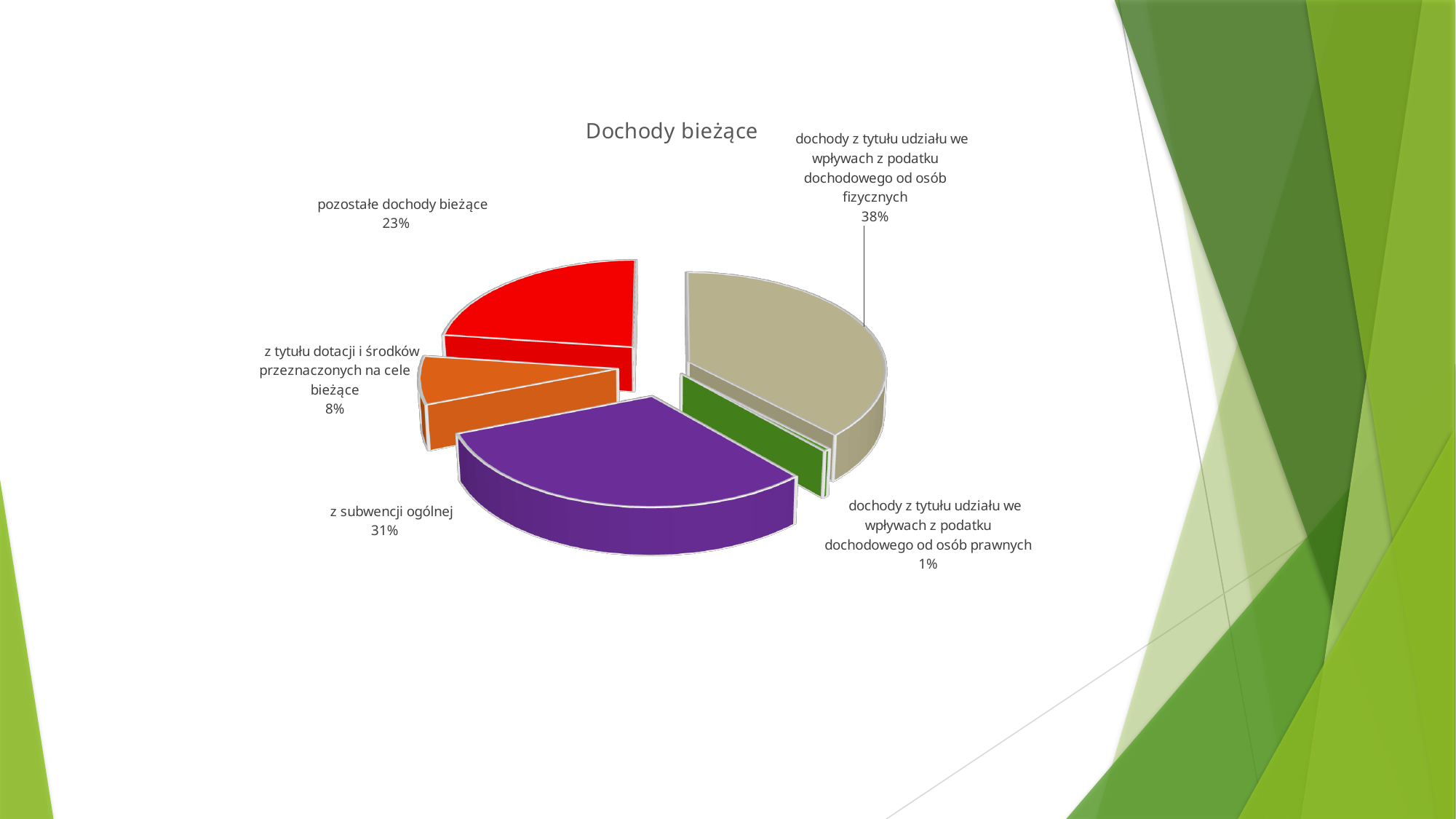
What is the title of the chart? Dochody bieżące Which is larger: the share for 'pozostałe dochody bieżące' or 'z tytułu dotacji i środków przeznaczonych na cele bieżące'? pozostałe dochody bieżące What type of chart is shown on the slide? pie chart What is the difference between the share for 'dochody z tytułu udziału we wpływach z podatku dochodowego od osób fizycznych' and 'z subwencji ogólnej'? 7% What is the value for 'z tytułu dotacji i środków przeznaczonych na cele bieżące'? 8% How many categories are shown in the pie chart? 5 What share does 'pozostałe dochody bieżące' have in the pie? 23% What is the value for 'dochody z tytułu udziału we wpływach z podatku dochodowego od osób fizycznych'? 38% What colour is the slice for 'z subwencji ogólnej'? purple What share does 'z subwencji ogólnej' have in the pie? 31% Which category has the largest share of the pie? dochody z tytułu udziału we wpływach z podatku dochodowego od osób fizycznych Which category has the smallest share of the pie? dochody z tytułu udziału we wpływach z podatku dochodowego od osób prawnych